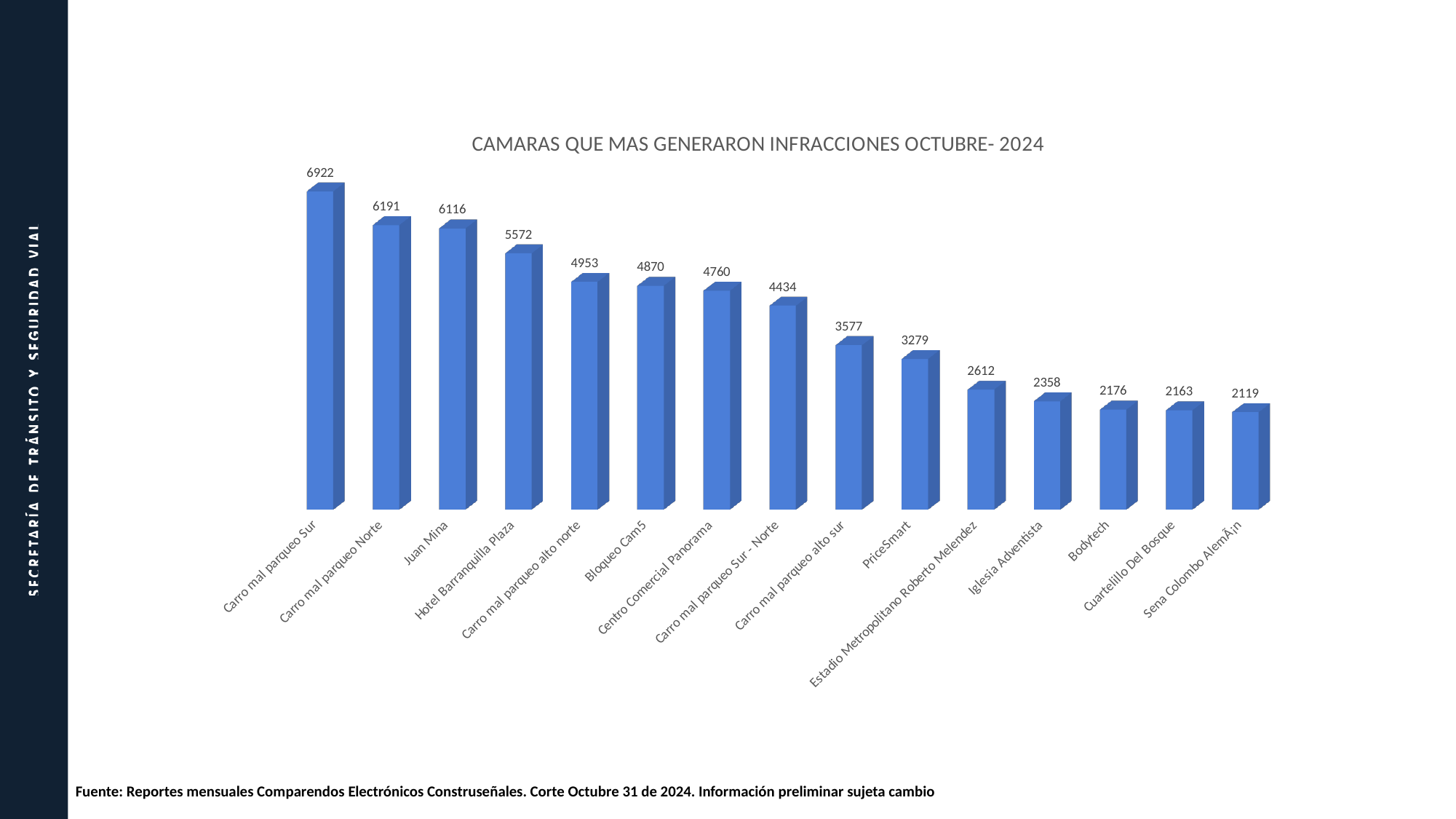
What is the value for PriceSmart? 3279 What is the value for Juan Mina? 6116 What is the value for Hotel Barranquilla Plaza? 5572 Which camera has the lowest value? Sena Colombo AlemÃ¡n What kind of chart is shown on the slide? Bar chart Which is larger, the value for Carro mal parqueo alto sur or the value for Estadio Metropolitano Roberto Melendez? Carro mal parqueo alto sur Which camera has the highest value? Carro mal parqueo Sur What is the value for Iglesia Adventista? 2358 Do the values rise or fall from left to right along the x axis? Fall How many cameras are shown in the chart? 15 What is the difference between the values for Bloqueo Cam5 and Centro Comercial Panorama? 110 What is the difference between the values for Carro mal parqueo Sur and Carro mal parqueo Norte? 731